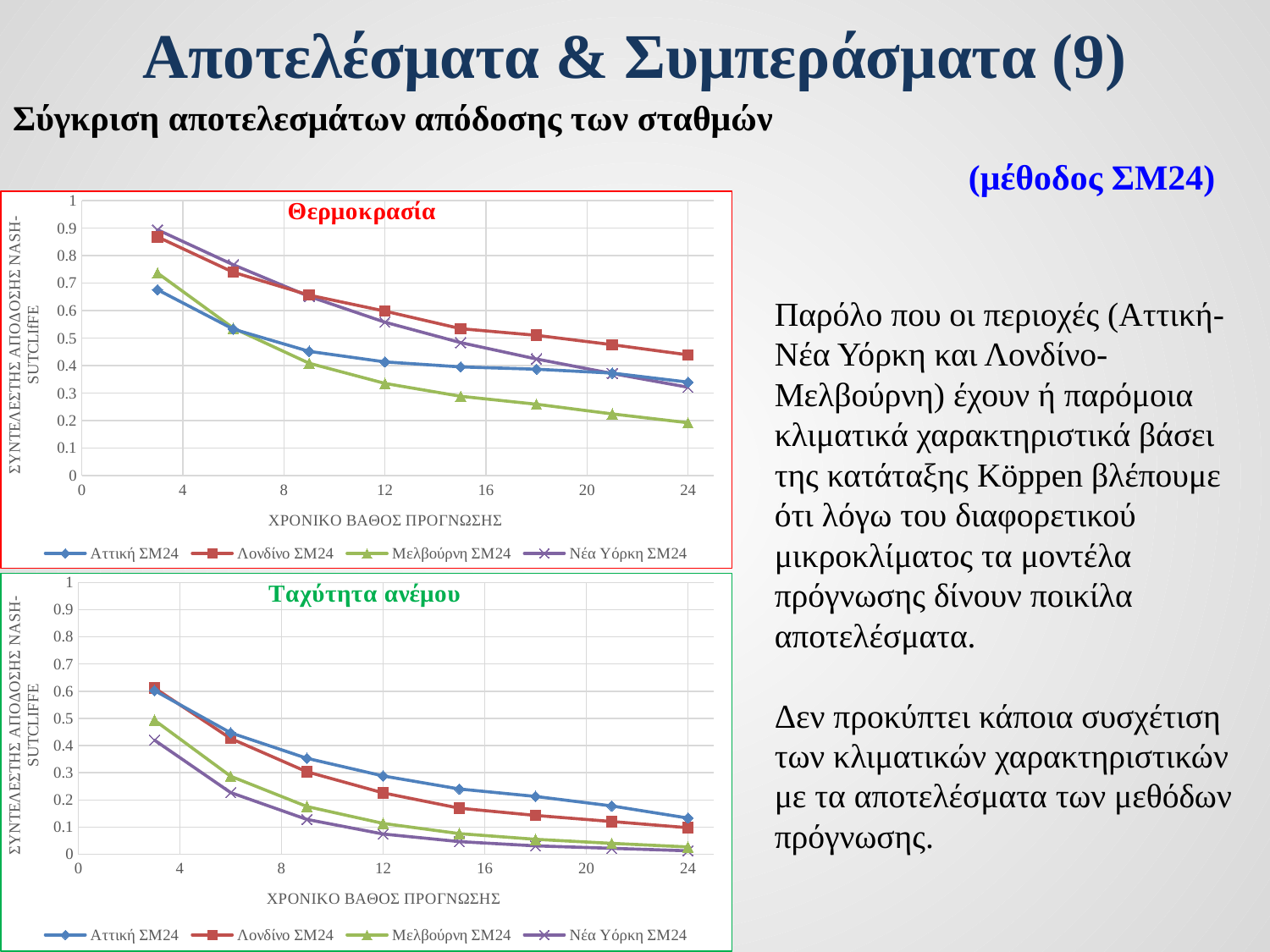
In the Θερμοκρασία chart, which series has the lowest value at x = 24? Μελβούρνη ΣΜ24 In the Ταχύτητα ανέμου chart, which series has the highest value at x = 24? Αττική ΣΜ24 In the Ταχύτητα ανέμου chart, which series has the lowest value at x = 3? Νέα Υόρκη ΣΜ24 In the Θερμοκρασία chart, which series has the highest value at x = 24? Λονδίνο ΣΜ24 In the Ταχύτητα ανέμου chart, is the value for Αττική ΣΜ24 at x = 3 greater or less than 0.5? greater In the Θερμοκρασία chart, how many series does the legend list? 4 What is the x-axis title of the Ταχύτητα ανέμου chart? ΧΡΟΝΙΚΟ ΒΑΘΟΣ ΠΡΟΓΝΩΣΗΣ In the Θερμοκρασία chart, what kind of chart is shown? line chart In the Θερμοκρασία chart, do the values rise or fall as the x axis increases? fall In the Θερμοκρασία chart, is the value for Μελβούρνη ΣΜ24 at x = 12 greater or less than 0.4? less In the Θερμοκρασία chart, how many data points does each series have? 8 In the Θερμοκρασία chart, at x = 3, which is larger: Λονδίνο ΣΜ24 or Αττική ΣΜ24? Λονδίνο ΣΜ24